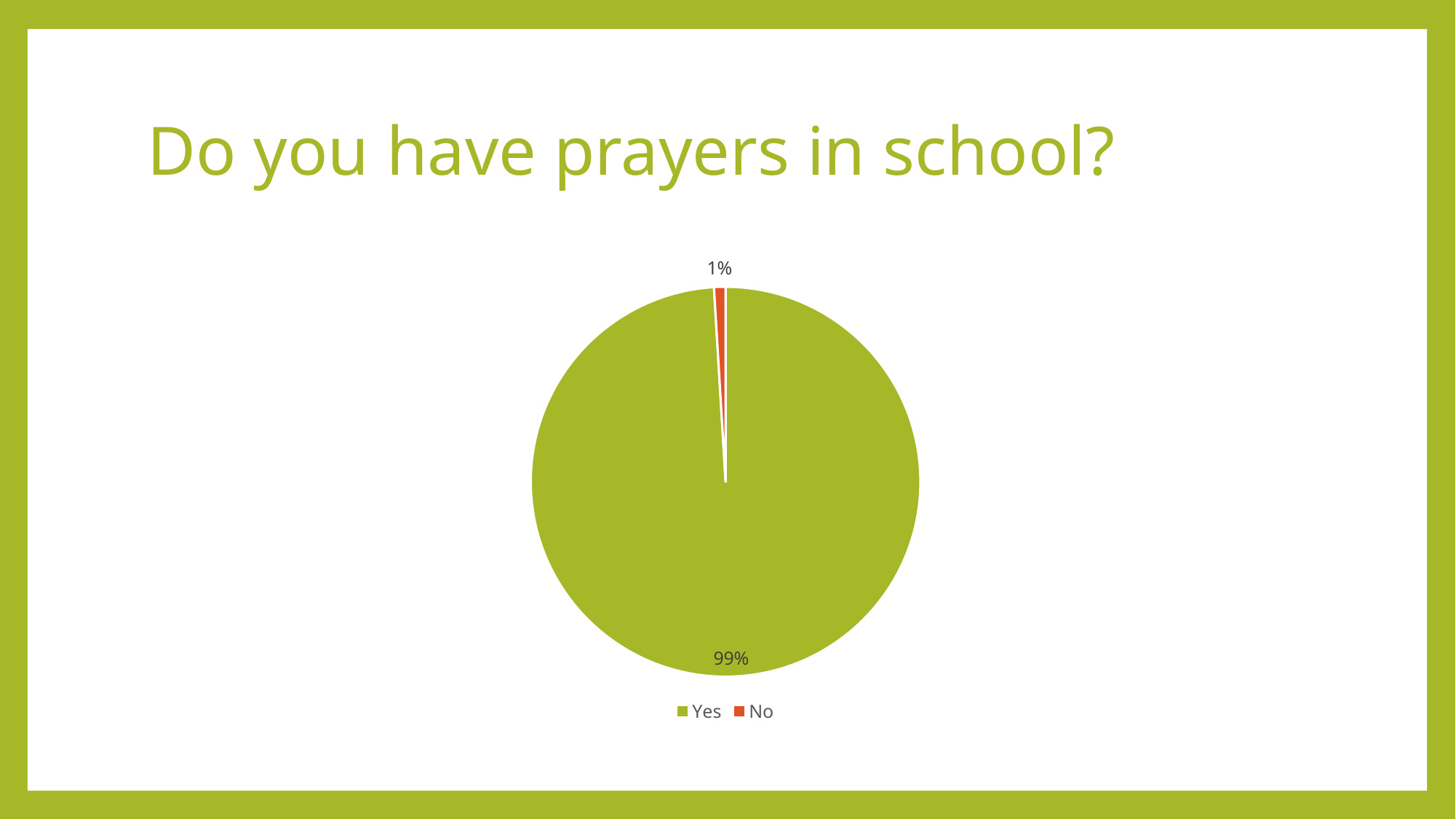
Which slice is the smallest in the pie chart? No How many slices does the pie chart have? 2 What share of the pie does the "Yes" slice represent? 99% How many entries does the legend list? 2 Which slice is the largest in the pie chart? Yes Which is larger, the "Yes" slice or the "No" slice? Yes What is the title of the slide above the chart? Do you have prayers in school? What is the difference in percentage points between the "Yes" and "No" slices? 98 What kind of chart is shown on the slide? pie chart What colour is the "No" slice in the pie chart? orange What share of the pie does the "No" slice represent? 1%